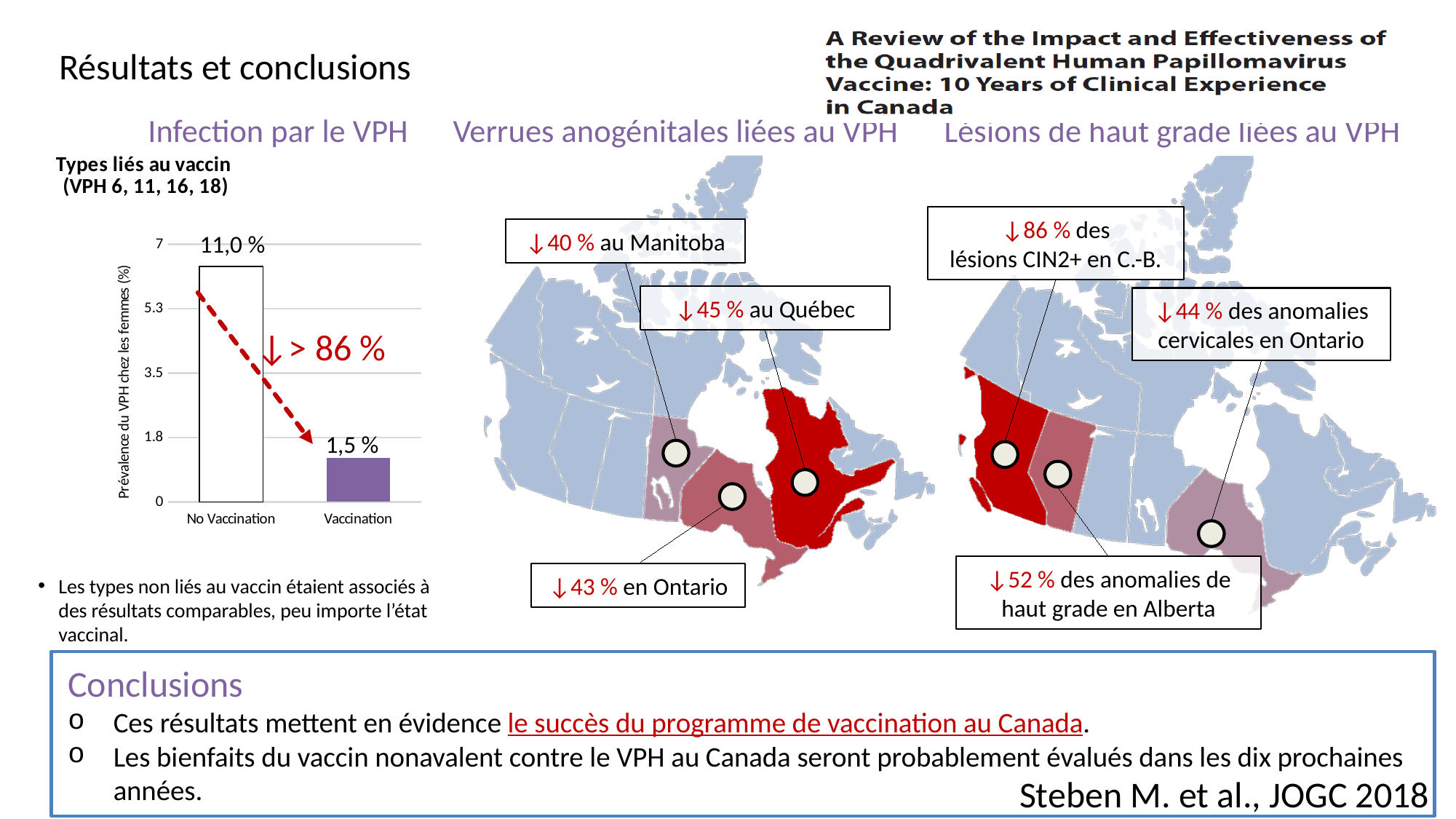
How many categories are shown in the 'Infection par le VPH' bar chart? 2 What percentage reduction is annotated with the red arrow on the 'Infection par le VPH' bar chart? > 86 % In the 'Infection par le VPH' bar chart, what is the difference between the No Vaccination and Vaccination values? 9,5 % In the 'Infection par le VPH' bar chart, is the value for Vaccination greater or less than 1.8? less In the 'Infection par le VPH' bar chart, what is the value for Vaccination? 1,5 % In the 'Infection par le VPH' bar chart, do the values rise or fall from No Vaccination to Vaccination? Fall In the 'Infection par le VPH' bar chart, what is the value for No Vaccination? 11,0 % What kind of chart is used for 'Infection par le VPH'? Bar chart What is the y-axis label of the 'Infection par le VPH' bar chart? Prévalence du VPH chez les femmes (%) In the 'Infection par le VPH' bar chart, which category has the lowest value? Vaccination In the 'Infection par le VPH' bar chart, which is larger, the value for No Vaccination or for Vaccination? No Vaccination In the 'Infection par le VPH' bar chart, which category has the highest value? No Vaccination